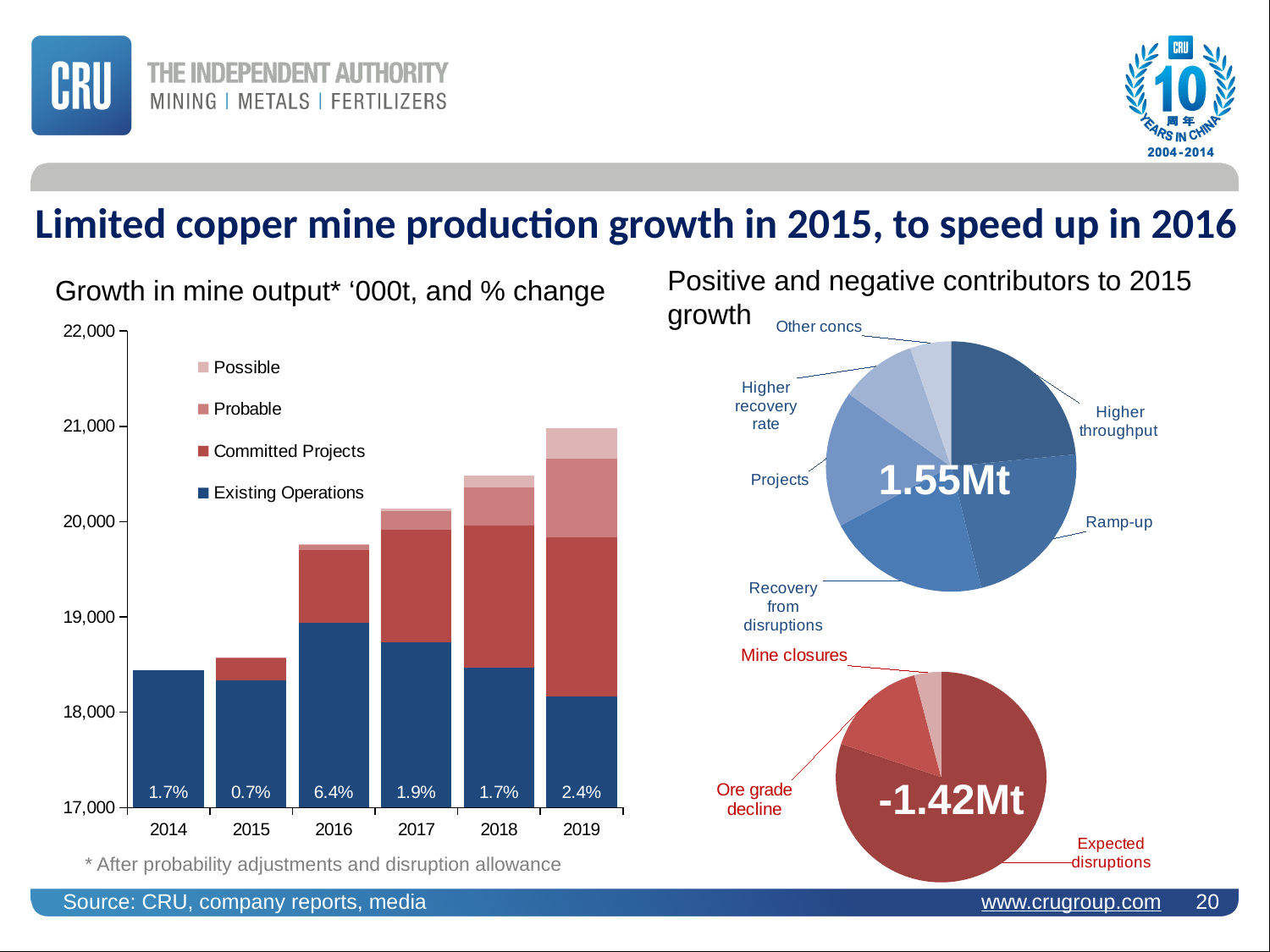
In the bar chart 'Growth in mine output', which year has the lowest % change label? 2015 What kind of chart is used for 'Growth in mine output'? Stacked bar chart In the bar chart 'Growth in mine output', what is the difference between the % change for 2016 and the % change for 2015? 5.7 percentage points In the bar chart 'Growth in mine output', is the total bar height for 2014 greater or less than 18,000? greater In the bar chart 'Growth in mine output', is the % change for 2019 larger or smaller than the % change for 2018? larger In the bar chart 'Growth in mine output', which year has the highest % change label? 2016 In the upper pie chart of positive contributors to 2015 growth, what total value is printed in the centre? 1.55Mt In the bar chart 'Growth in mine output', what is the % change shown for 2016? 6.4% In the bar chart 'Growth in mine output', how many years are shown on the x axis? 6 In the lower pie chart of negative contributors to 2015 growth, which slice is the largest? Expected disruptions In the bar chart 'Growth in mine output', how many series does the legend list? 4 In the bar chart 'Growth in mine output', what is the % change shown for 2015? 0.7%